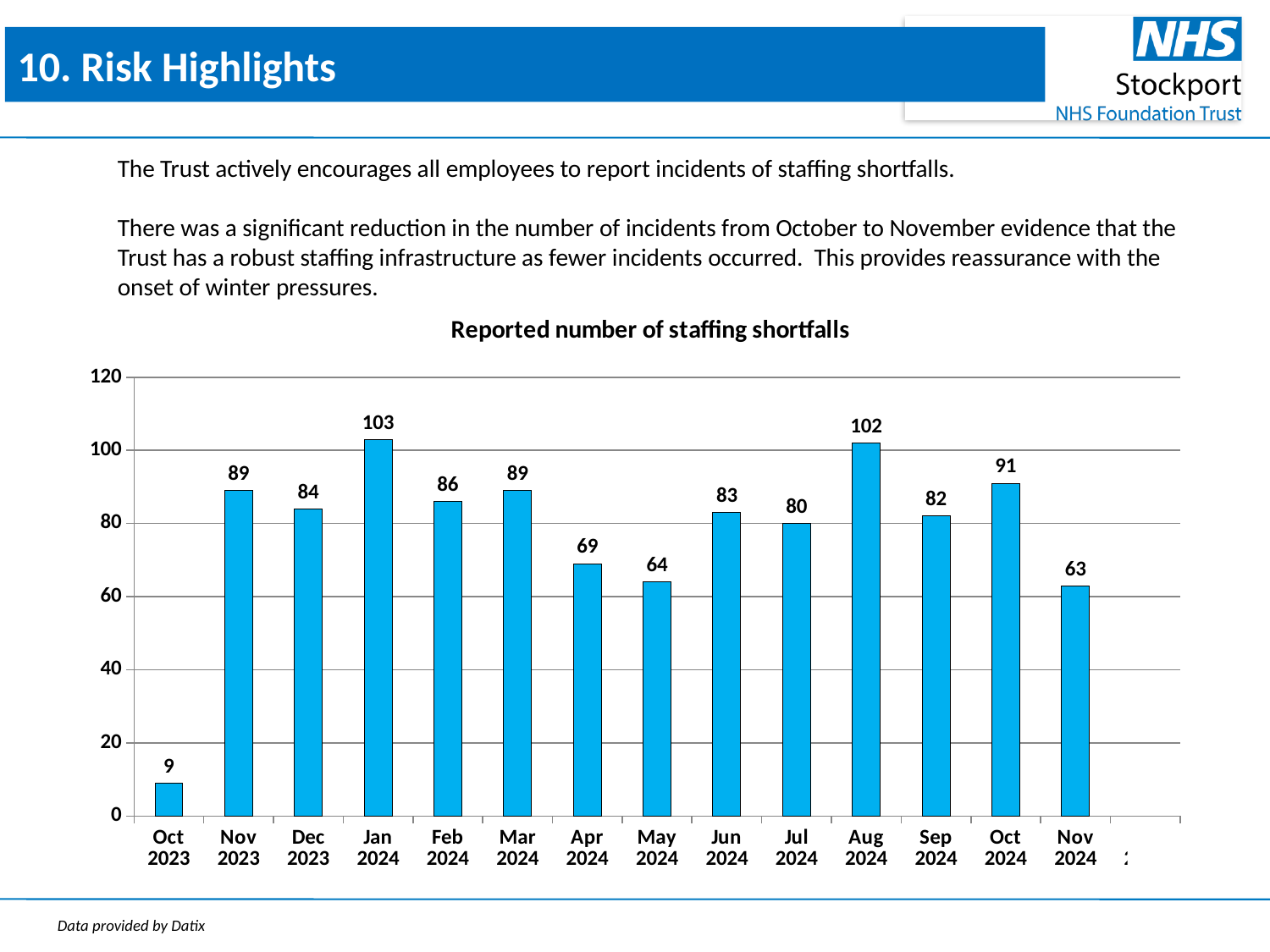
What is the reported number of staffing shortfalls for Nov 2024? 63 Is the value for Jul 2024 greater or less than 100? less Which month has more reported staffing shortfalls, Aug 2024 or Sep 2024? Aug 2024 What is the reported number of staffing shortfalls for May 2024? 64 Do the values rise or fall from Oct 2024 to Nov 2024? fall What is the title of the chart? Reported number of staffing shortfalls Which month has the lowest reported number of staffing shortfalls? Oct 2023 How many months are shown with bars on the chart? 14 What is the reported number of staffing shortfalls for Jan 2024? 103 Which month has the highest reported number of staffing shortfalls? Jan 2024 What is the difference between the reported staffing shortfalls for Oct 2024 and Nov 2024? 28 What kind of chart is used to show the reported number of staffing shortfalls? bar chart